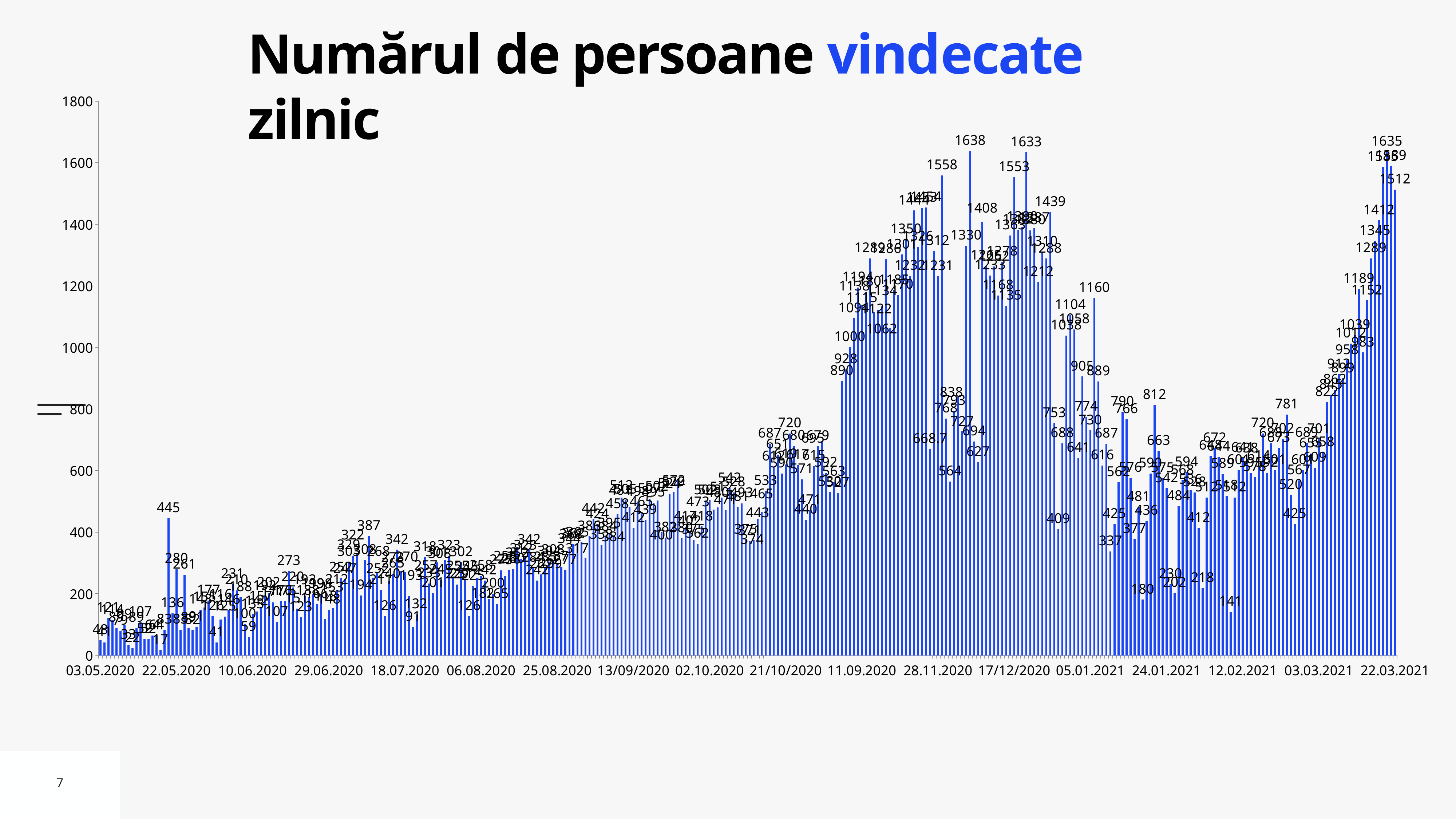
What kind of chart is shown on the slide? bar chart Is the highest value on the chart greater or less than 1600? greater How many date labels are shown on the x axis? 18 What is the first date label on the x axis? 03.05.2020 What is the difference between the labeled values 1638 and 1558? 80 Overall, do the values rise or fall from the left of the x axis to the right? rise What is the difference between the labeled values 1635 and 1512? 123 What is the highest value labeled on the chart? 1638 What is the maximum value shown on the y axis? 1800 Which is larger, the labeled value 1638 or the labeled value 1512? 1638 What is the title of the chart? Numărul de persoane vindecate zilnic